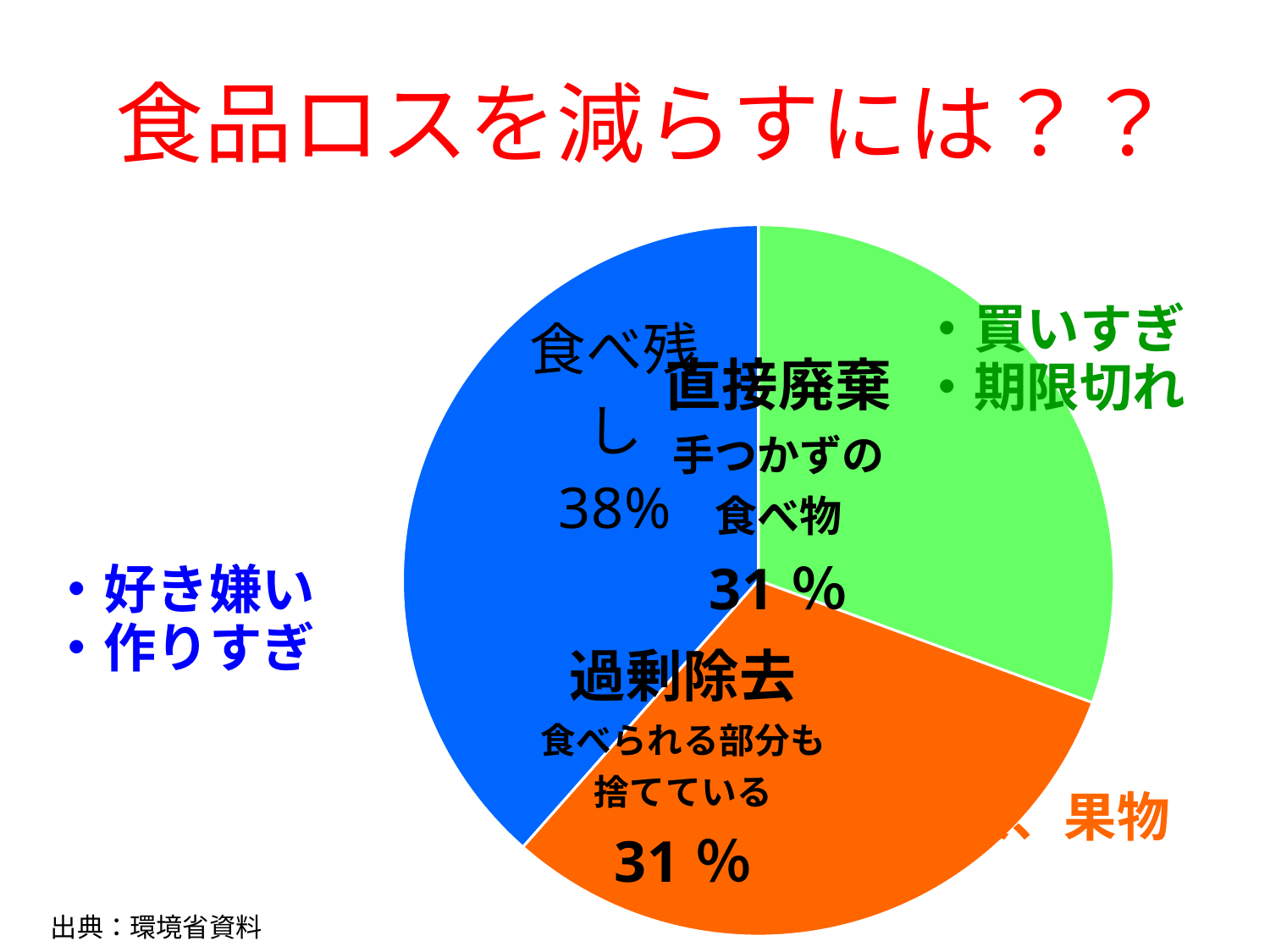
What percentage of the pie is labelled 食べ残し? 38% Which slice of the pie chart is the largest? 食べ残し What kind of chart is shown on the slide? pie chart What is the title of the slide containing the pie chart? 食品ロスを減らすには？？ How many slices does the pie chart have? 3 What colour is the 食べ残し slice of the pie chart? blue By how many percentage points does the 食べ残し slice exceed the 過剰除去 slice? 7 What percentage of the pie is labelled 過剰除去? 31 % Which is larger, the 食べ残し slice or the 直接廃棄 slice? 食べ残し What percentage of the pie is labelled 直接廃棄? 31 % What share of the pie does the 食べ残し slice represent? 38%